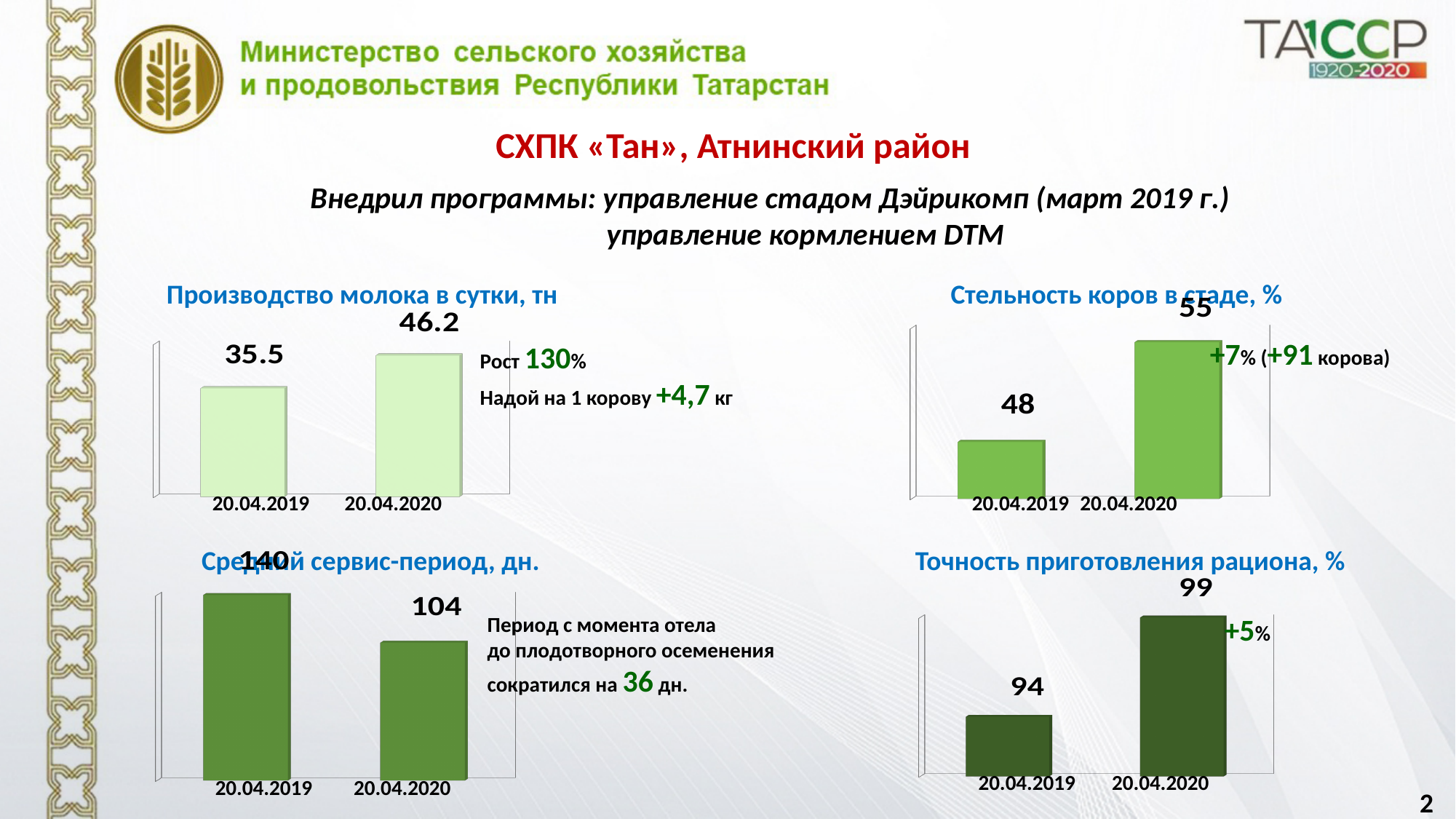
In the chart titled "Средний сервис-период, дн.", what is the value for 20.04.2020? 104 In the chart titled "Средний сервис-период, дн.", which date has the lower value? 20.04.2020 In the chart titled "Производство молока в сутки, тн", what is the difference between the 20.04.2020 and 20.04.2019 values? 10.7 In the chart titled "Производство молока в сутки, тн", what is the value for 20.04.2019? 35.5 In the chart titled "Стельность коров в стаде, %", which date has the higher value? 20.04.2020 What kind of chart is the one titled "Точность приготовления рациона, %"? bar chart In the chart titled "Производство молока в сутки, тн", what is the value for 20.04.2020? 46.2 In the chart titled "Точность приготовления рациона, %", what is the value for 20.04.2019? 94 In the chart titled "Средний сервис-период, дн.", do the values rise or fall from 20.04.2019 to 20.04.2020? fall In the chart titled "Точность приготовления рациона, %", what is the difference between the 20.04.2020 and 20.04.2019 values? 5 In the chart titled "Стельность коров в стаде, %", what is the value for 20.04.2019? 48 In the chart titled "Стельность коров в стаде, %", what is the difference between the 20.04.2020 and 20.04.2019 values? 7